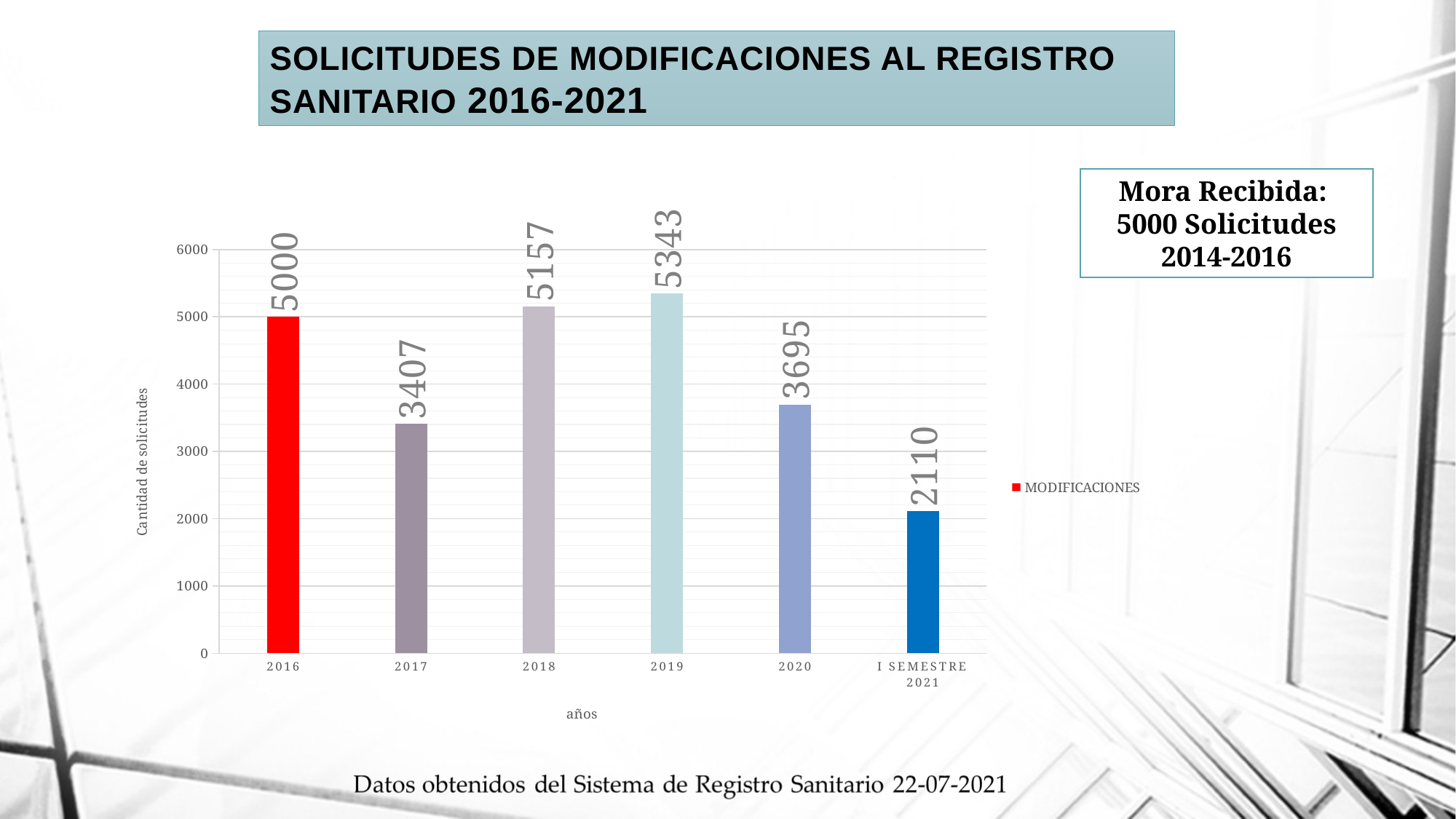
What kind of chart is shown on the slide? bar chart Which category has the lowest value? I SEMESTRE 2021 Which is larger, the value for 2020 or the value for 2017? 2020 What series name is shown in the legend? MODIFICACIONES How many categories are shown on the x axis? 6 What is the value for 2019? 5343 What is the value for I SEMESTRE 2021? 2110 What is the difference between the values for 2018 and 2017? 1750 What is the value for 2016? 5000 What is the label of the y axis? Cantidad de solicitudes How many series does the legend list? 1 Which year has the highest value? 2019